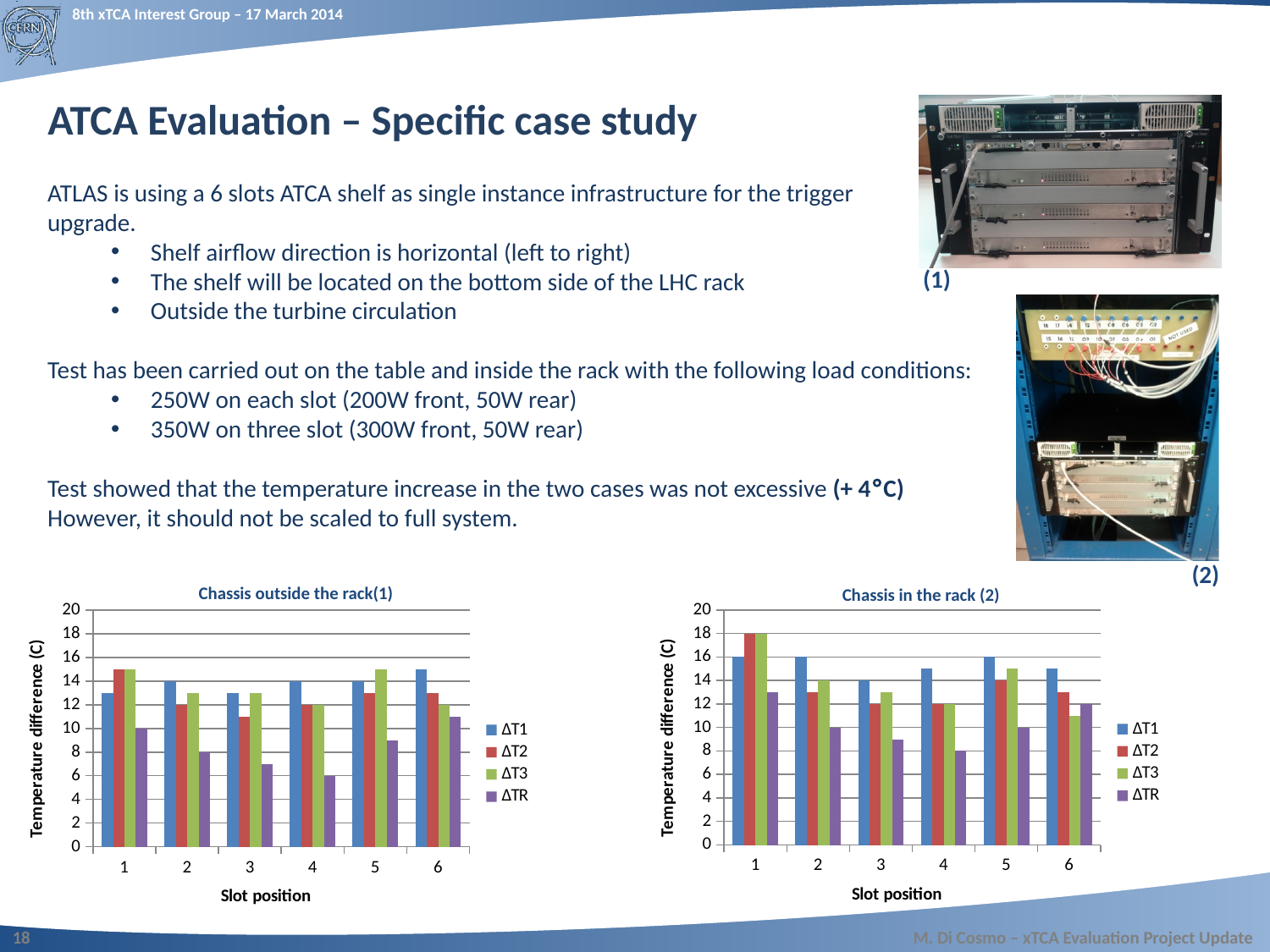
How many series does the legend of "Chassis in the rack (2)" list? 4 In "Chassis in the rack (2)", is the ΔT3 value at slot position 1 greater or less than 16? greater In "Chassis outside the rack(1)", what is the ΔT1 value at slot position 2? 14 What type of chart is "Chassis outside the rack(1)"? bar chart How many slot positions are shown on the x axis of "Chassis outside the rack(1)"? 6 In "Chassis outside the rack(1)", is the ΔTR value at slot position 3 greater or less than 8? less In "Chassis in the rack (2)", what is the ΔT2 value at slot position 1? 18 In "Chassis outside the rack(1)", which is larger at slot position 1: ΔT1 or ΔT2? ΔT2 What is the y-axis label of "Chassis in the rack (2)"? Temperature difference (C) In "Chassis in the rack (2)", which slot position has the lowest ΔTR value? 4 In "Chassis in the rack (2)", what is the ΔT1 value at slot position 1? 16 In "Chassis outside the rack(1)", what is the ΔTR value at slot position 4? 6